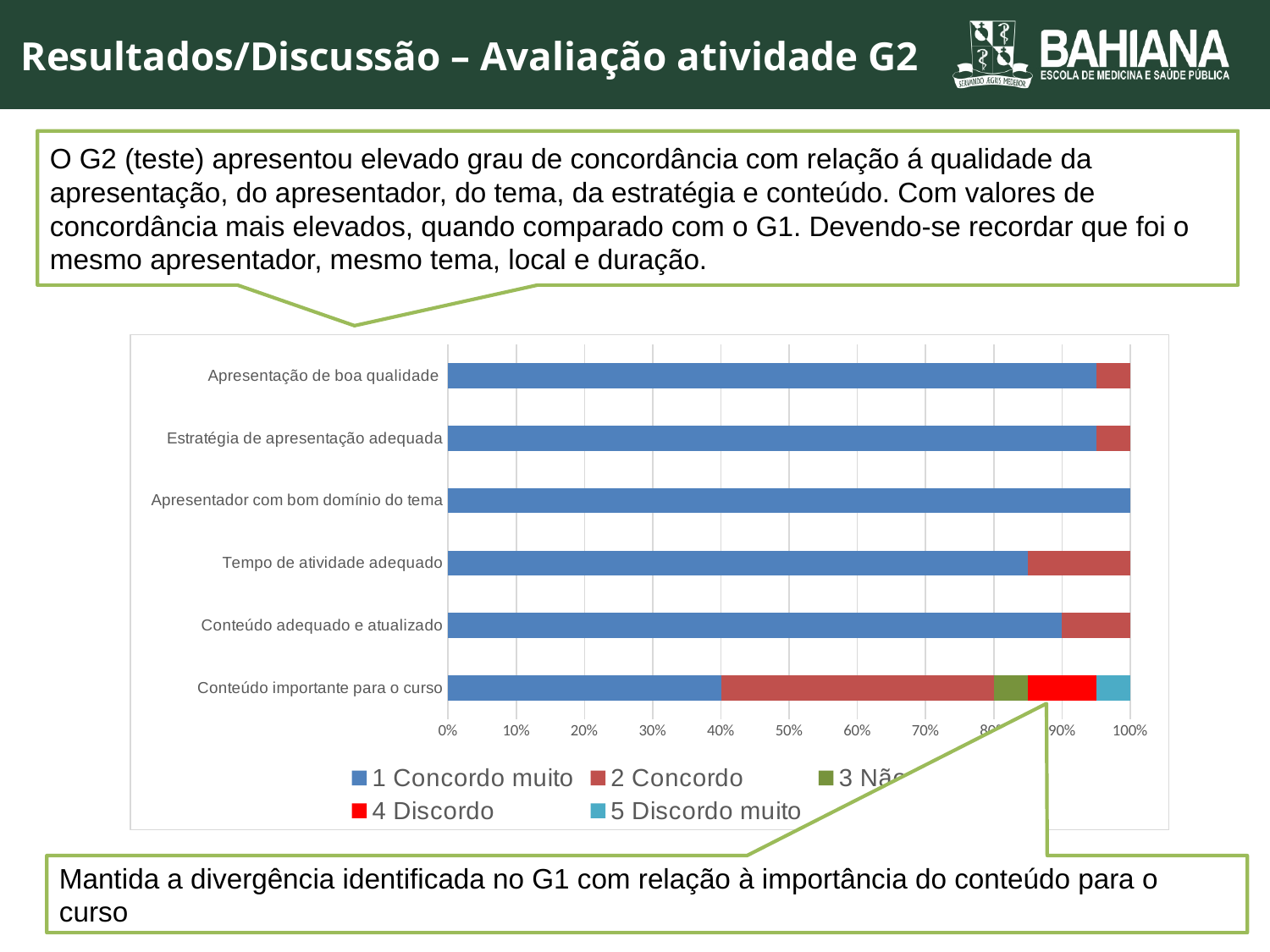
Which category has the smallest '1 Concordo muito' share? Conteúdo importante para o curso Which category is the only one showing all five response series in its bar? Conteúdo importante para o curso Is the '1 Concordo muito' share for 'Tempo de atividade adequado' greater or less than 80%? greater Which has the larger '1 Concordo muito' share: 'Tempo de atividade adequado' or 'Conteúdo adequado e atualizado'? Conteúdo adequado e atualizado Which category has the largest '1 Concordo muito' share? Apresentador com bom domínio do tema Is the '1 Concordo muito' share for 'Conteúdo importante para o curso' greater or less than 50%? less What colour represents the '4 Discordo' series in the chart? Red How many series does the chart legend list? 5 Is the '1 Concordo muito' share for 'Apresentação de boa qualidade' greater or less than 90%? greater How many categories (statements) are plotted on the chart? 6 What kind of chart is shown on the slide? Stacked bar chart